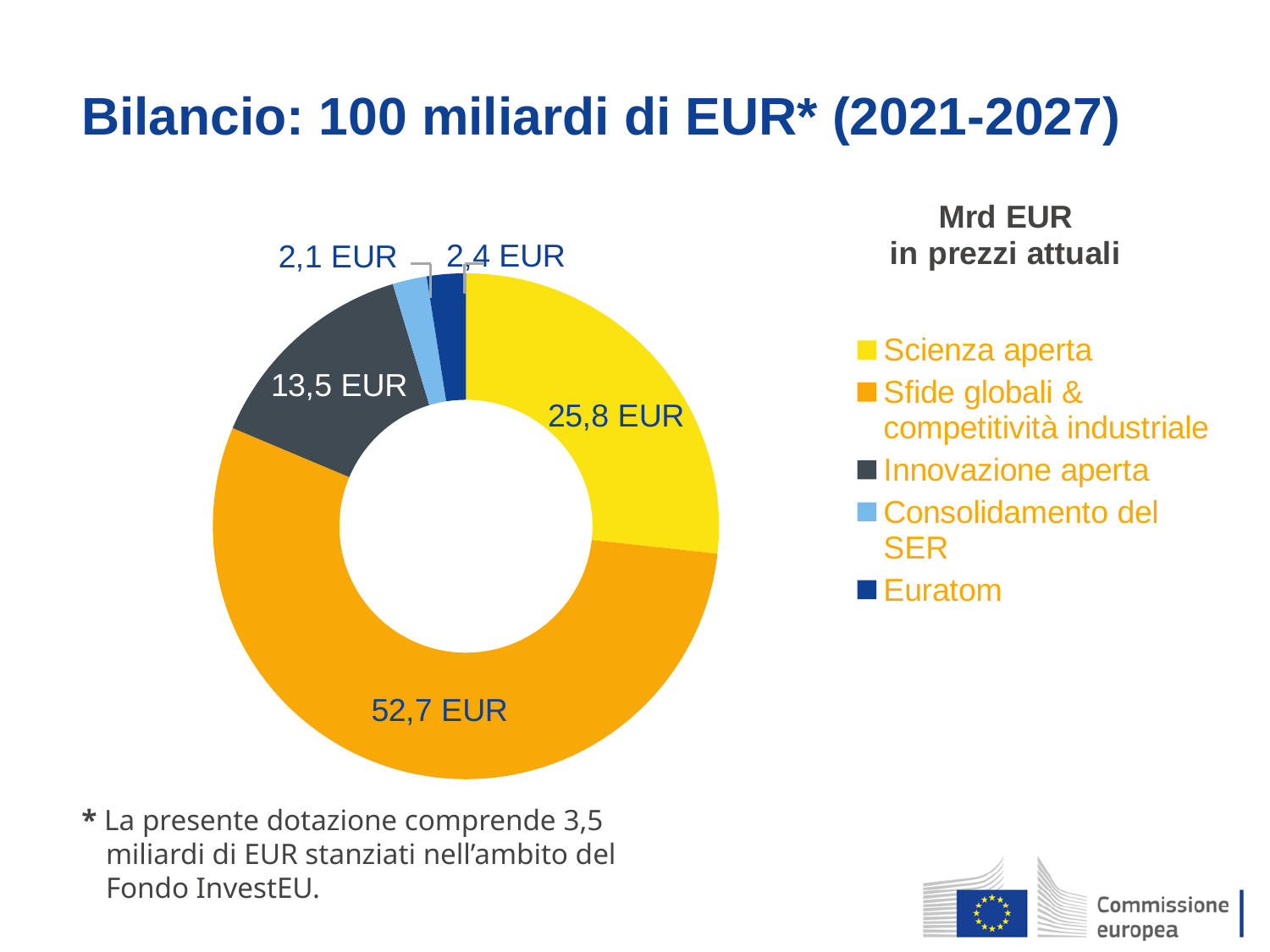
What is the value shown for Consolidamento del SER? 2,1 EUR Which is larger, the value for Euratom or the value for Consolidamento del SER? Euratom How many categories does the chart show? 5 Which category has the smallest slice? Consolidamento del SER What kind of chart is shown on the slide? doughnut chart What is the value shown for Innovazione aperta? 13,5 EUR What is the value shown for Scienza aperta? 25,8 EUR Which category has the largest slice? Sfide globali & competitività industriale What is the difference between the values for Sfide globali & competitività industriale and Scienza aperta? 26,9 EUR What is the difference between the values for Scienza aperta and Innovazione aperta? 12,3 EUR What is the value shown for Sfide globali & competitività industriale? 52,7 EUR What is the value shown for Euratom? 2,4 EUR